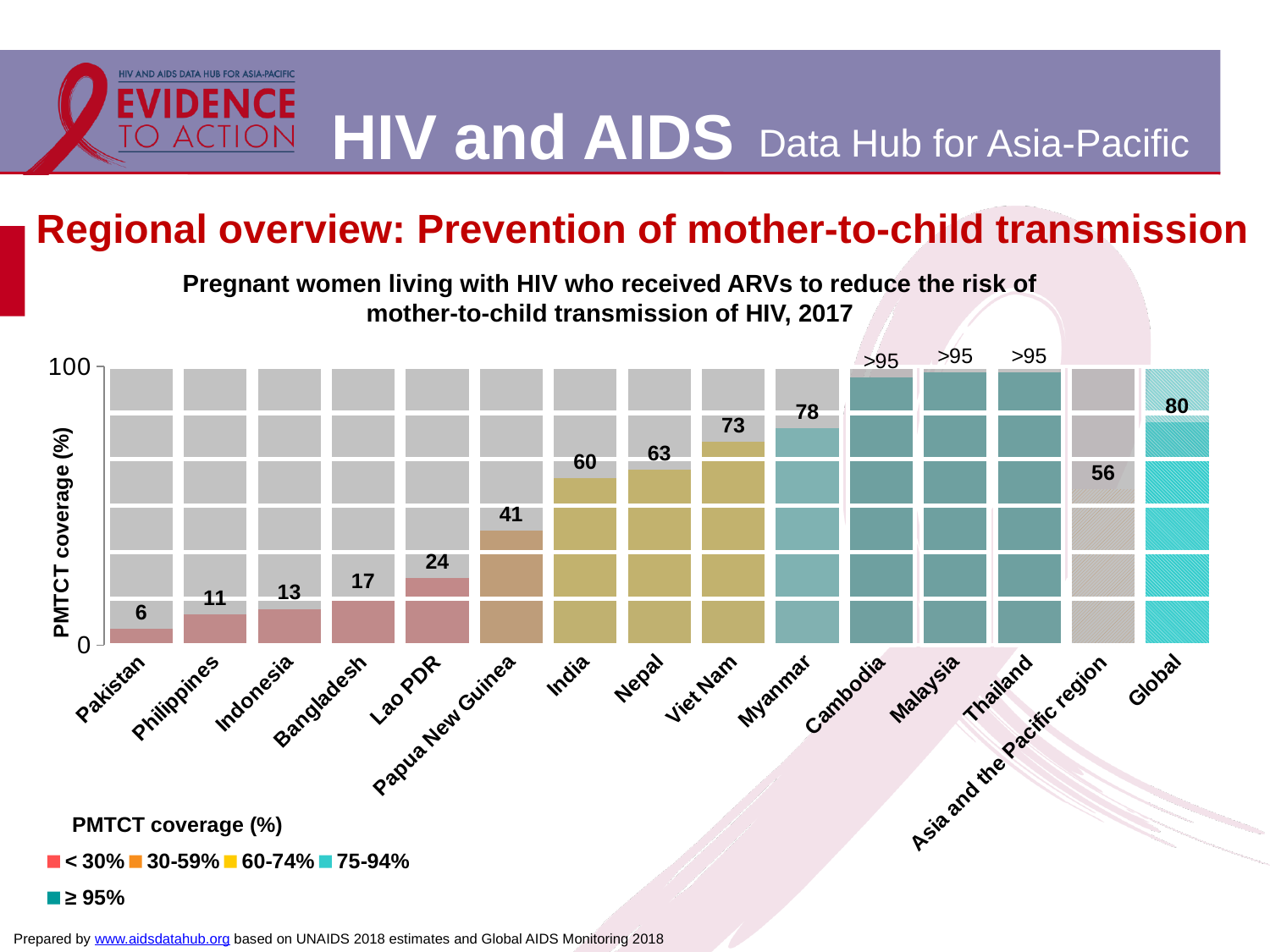
What is the PMTCT coverage value shown for Thailand? >95 What kind of chart is shown on the slide? Bar chart What is the PMTCT coverage value shown for Pakistan? 6 How many entries does the PMTCT coverage (%) legend list? 5 Which category has the lowest PMTCT coverage value? Pakistan What is the difference between the values for Myanmar and Viet Nam? 5 What is the difference between the Global value and the Asia and the Pacific region value? 24 Which has a larger value, India or Nepal? Nepal What is the PMTCT coverage value shown for Papua New Guinea? 41 How many categories are shown on the x axis of the chart? 15 What is the PMTCT coverage value shown for Viet Nam? 73 What is the PMTCT coverage value shown for the Asia and the Pacific region? 56